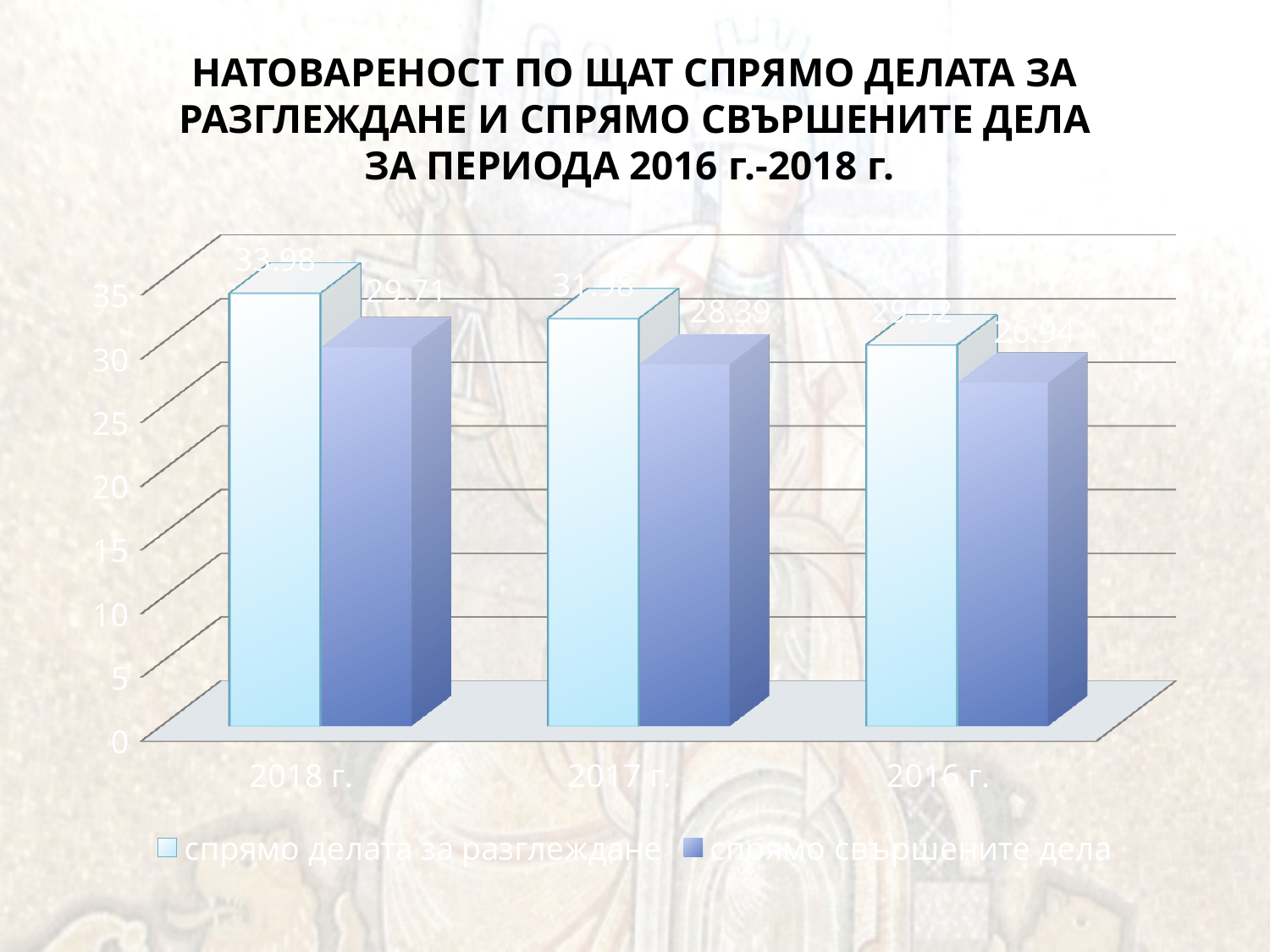
How many series does the legend list? 2 Which is larger for 2016 г.: "спрямо делата за разглеждане" or "спрямо свършените дела"? спрямо делата за разглеждане What is the value for 2018 г. in the series "спрямо делата за разглеждане"? 33.98 What is the value for 2017 г. in the series "спрямо свършените дела"? 28.39 What is the value for 2016 г. in the series "спрямо свършените дела"? 26.94 What is the value for 2018 г. in the series "спрямо свършените дела"? 29.71 What is the value for 2016 г. in the series "спрямо делата за разглеждане"? 29.92 How many years are shown on the x axis? 3 What is the difference between the two series for 2018 г.? 4.27 What kind of chart is shown on the slide? bar chart Which year has the highest value in the series "спрямо делата за разглеждане"? 2018 г. Which year has the lowest value in the series "спрямо свършените дела"? 2016 г.